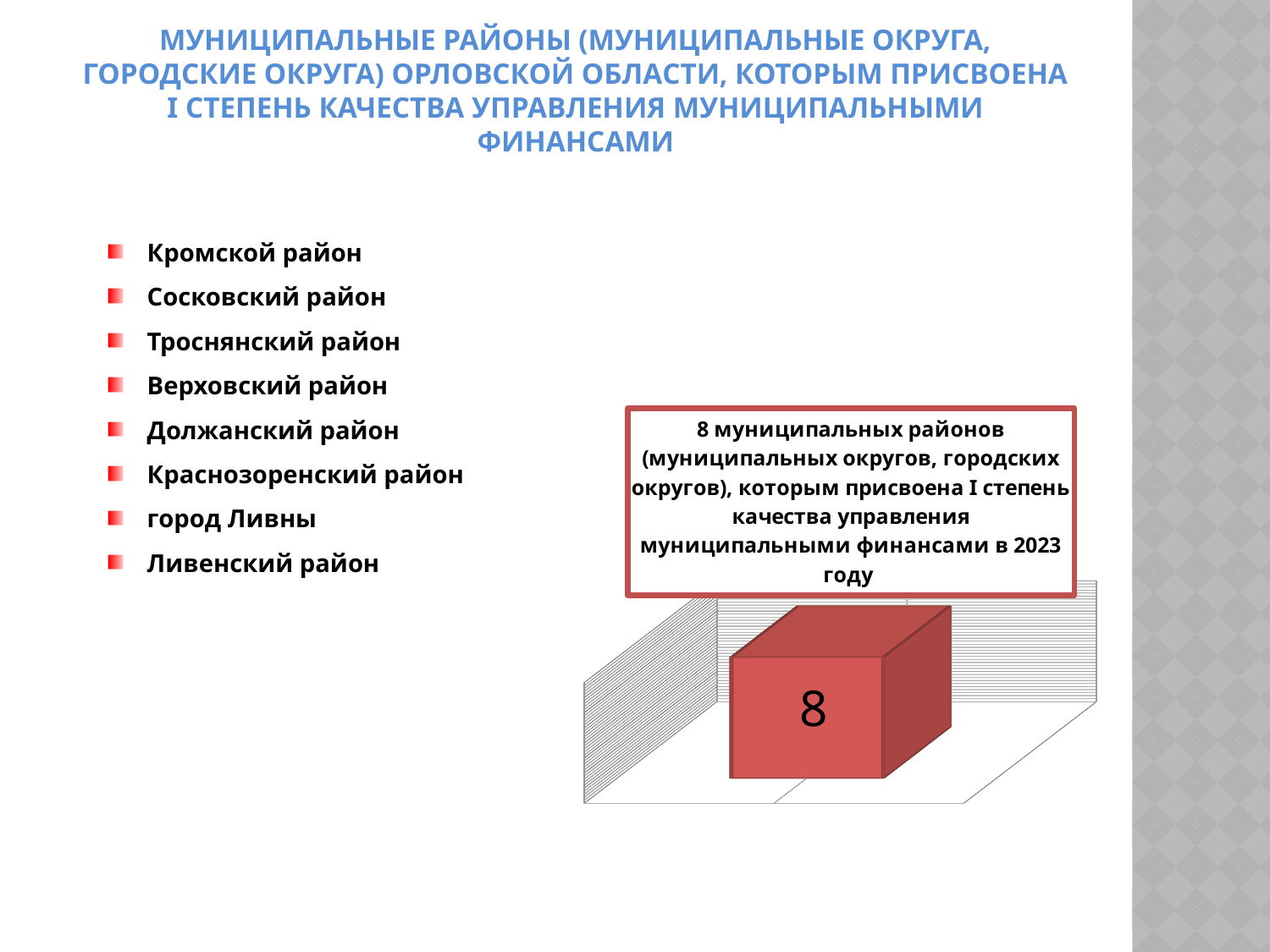
What value is printed on the single bar in the chart? 8 What colour is the bar in the chart? red What kind of chart is shown on the slide? bar chart According to the text box above the chart, how many municipal districts were assigned the I degree of quality of municipal finance management in 2023? 8 Is the value shown on the bar greater or less than 5? greater Which year does the text box above the chart refer to? 2023 How many bars does the chart show? 1